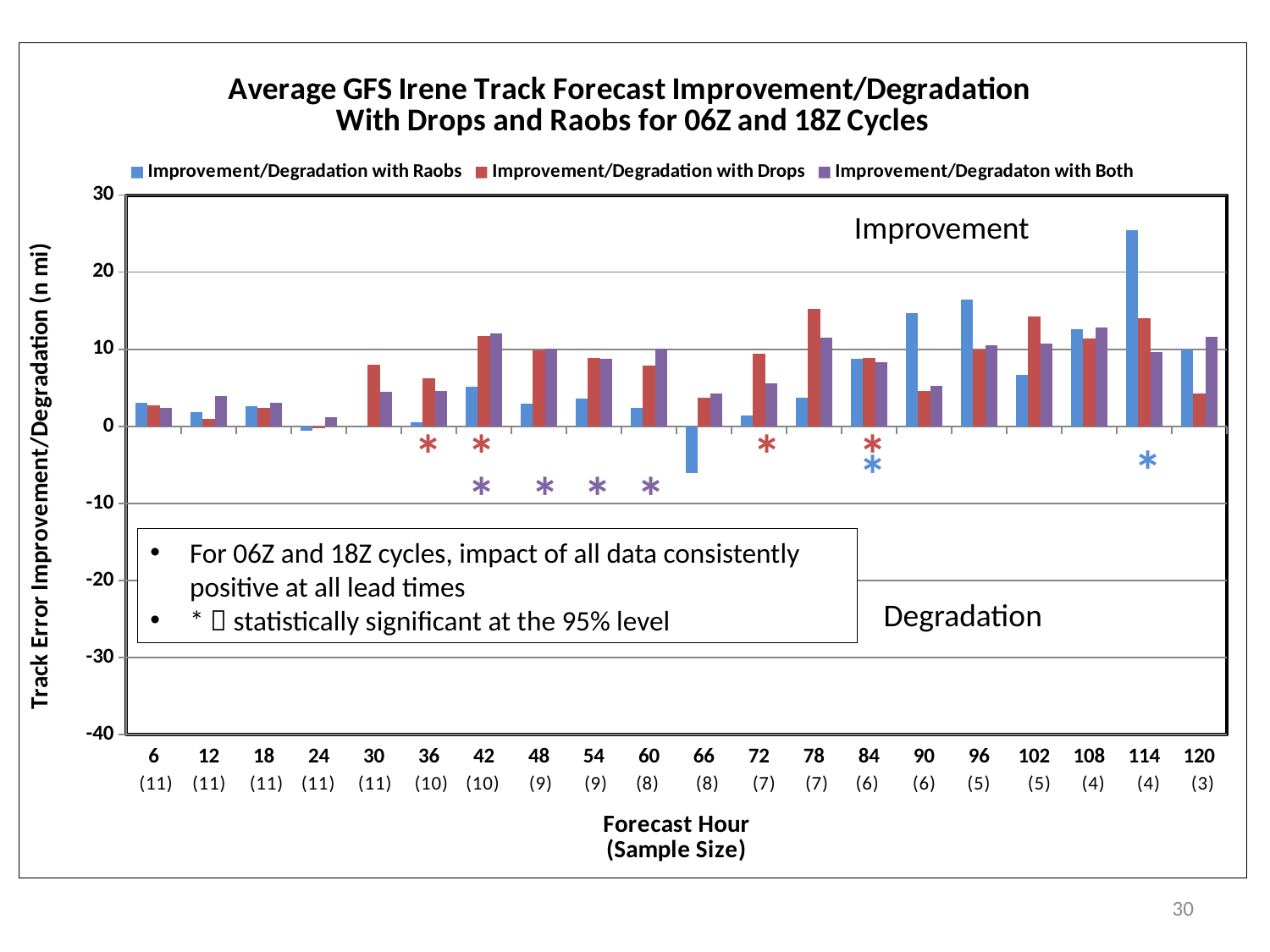
Is the value for Improvement/Degradation with Drops at forecast hour 78 greater or less than 10? greater Is the value for Improvement/Degradation with Raobs at forecast hour 114 greater or less than 20? greater At forecast hour 78, which is larger: Improvement/Degradation with Raobs or Improvement/Degradation with Drops? Improvement/Degradation with Drops What kind of chart is shown on the slide? bar chart At which forecast hour is the Improvement/Degradation with Raobs bar lowest? 66 What is the title of the y axis? Track Error Improvement/Degradation (n mi) Is the value for Improvement/Degradation with Raobs at forecast hour 66 greater or less than 0? less How many series does the legend list? 3 At forecast hour 114, which is larger: Improvement/Degradation with Raobs or Improvement/Degradation with Drops? Improvement/Degradation with Raobs How many forecast hour categories are shown on the x axis? 20 At which forecast hour is the Improvement/Degradation with Raobs bar highest? 114